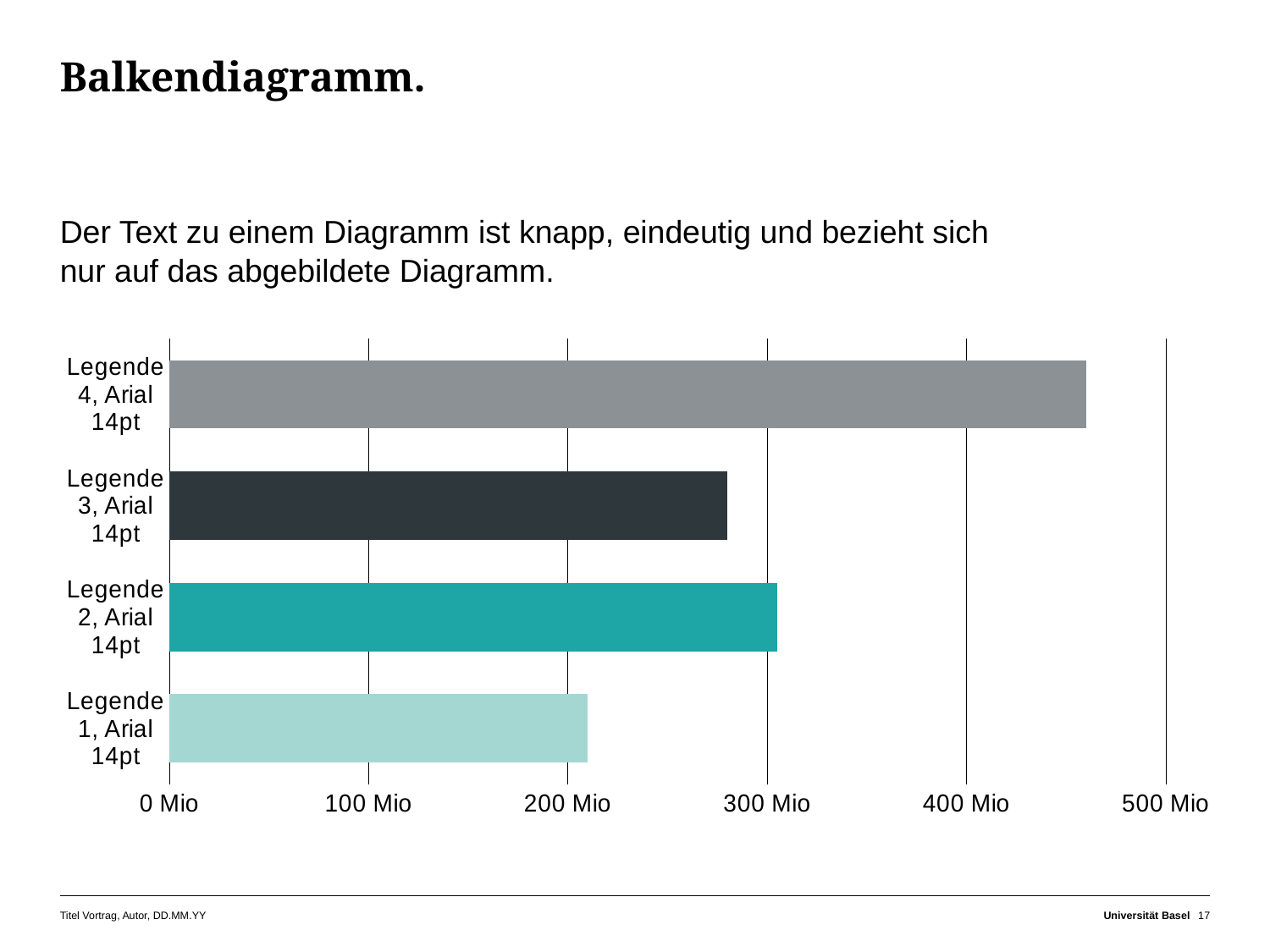
What is the highest value shown on the horizontal axis? 500 Mio Which is larger, the value for Legende 4, Arial 14pt or the value for Legende 1, Arial 14pt? Legende 4, Arial 14pt What is the title of the slide containing the chart? Balkendiagramm. Which category has the highest value? Legende 4, Arial 14pt What kind of chart is shown on the slide? bar chart Which is larger, the value for Legende 2, Arial 14pt or the value for Legende 3, Arial 14pt? Legende 2, Arial 14pt How many categories (bars) does the chart show? 4 Is the value for Legende 4, Arial 14pt greater or less than 400 Mio? greater Is the value for Legende 1, Arial 14pt greater or less than 300 Mio? less Is the value for Legende 3, Arial 14pt greater or less than 300 Mio? less Which category has the lowest value? Legende 1, Arial 14pt